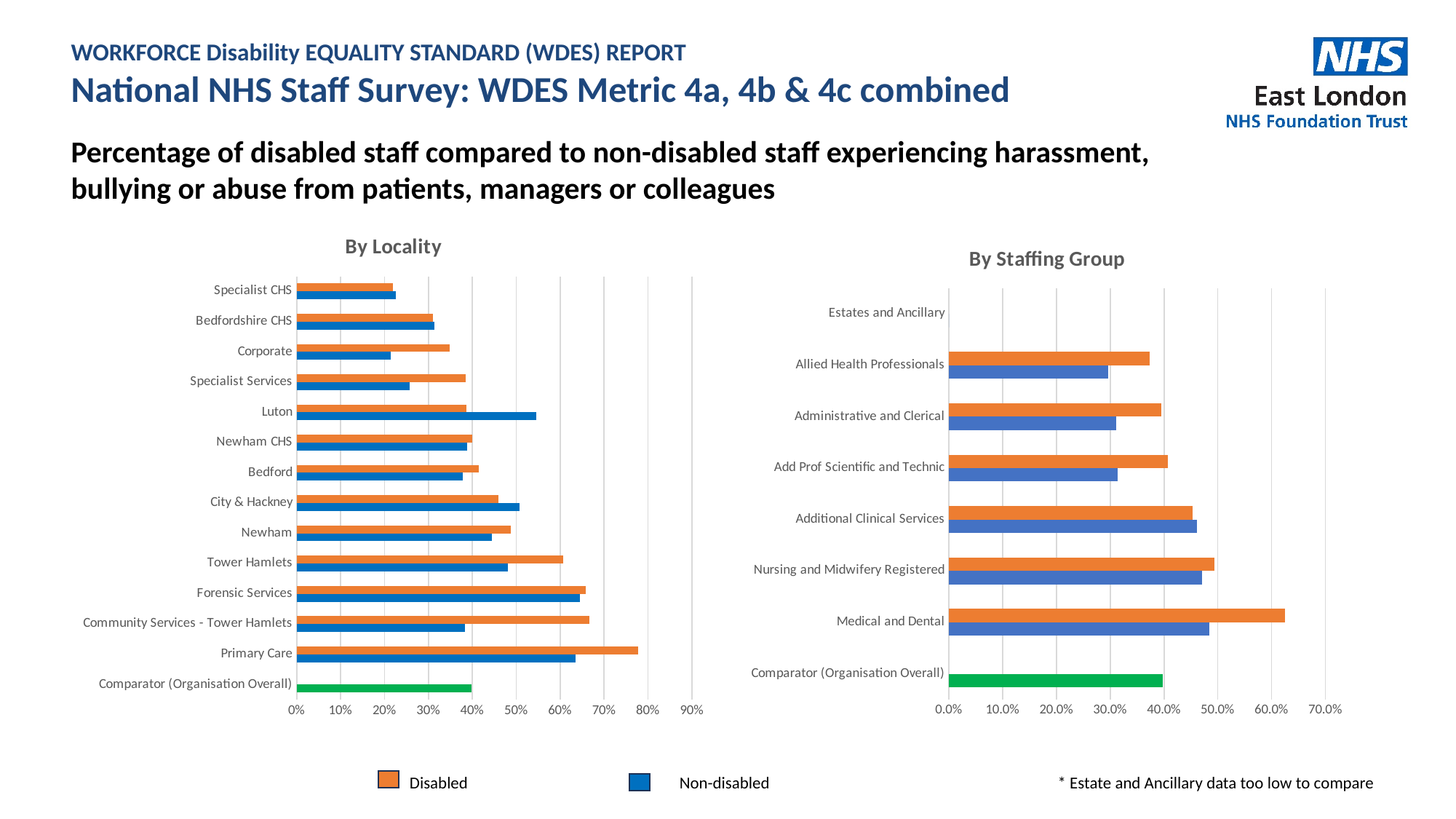
In the By Locality chart, which locality has the highest value for Disabled staff? Primary Care In the By Staffing Group chart, which staffing group has the highest value for Disabled staff? Medical and Dental How many categories are shown on the y axis of the By Locality chart? 14 In the By Locality chart, which locality has the lowest value for Disabled staff? Specialist CHS In the By Staffing Group chart, is the Disabled value for Medical and Dental greater or less than 60.0%? greater In the By Locality chart, for Luton, which is larger: the Disabled value or the Non-disabled value? Non-disabled How many series does the legend list for the charts on the slide? 2 In the By Locality chart, is the Non-disabled value for Luton greater or less than 50%? greater What type of chart is the By Staffing Group chart? Bar chart In the By Staffing Group chart, for Administrative and Clerical, which is larger: the Disabled value or the Non-disabled value? Disabled In the By Locality chart, for Corporate, which is larger: the Disabled value or the Non-disabled value? Disabled In the By Locality chart, is the Disabled value for Primary Care greater or less than 70%? greater